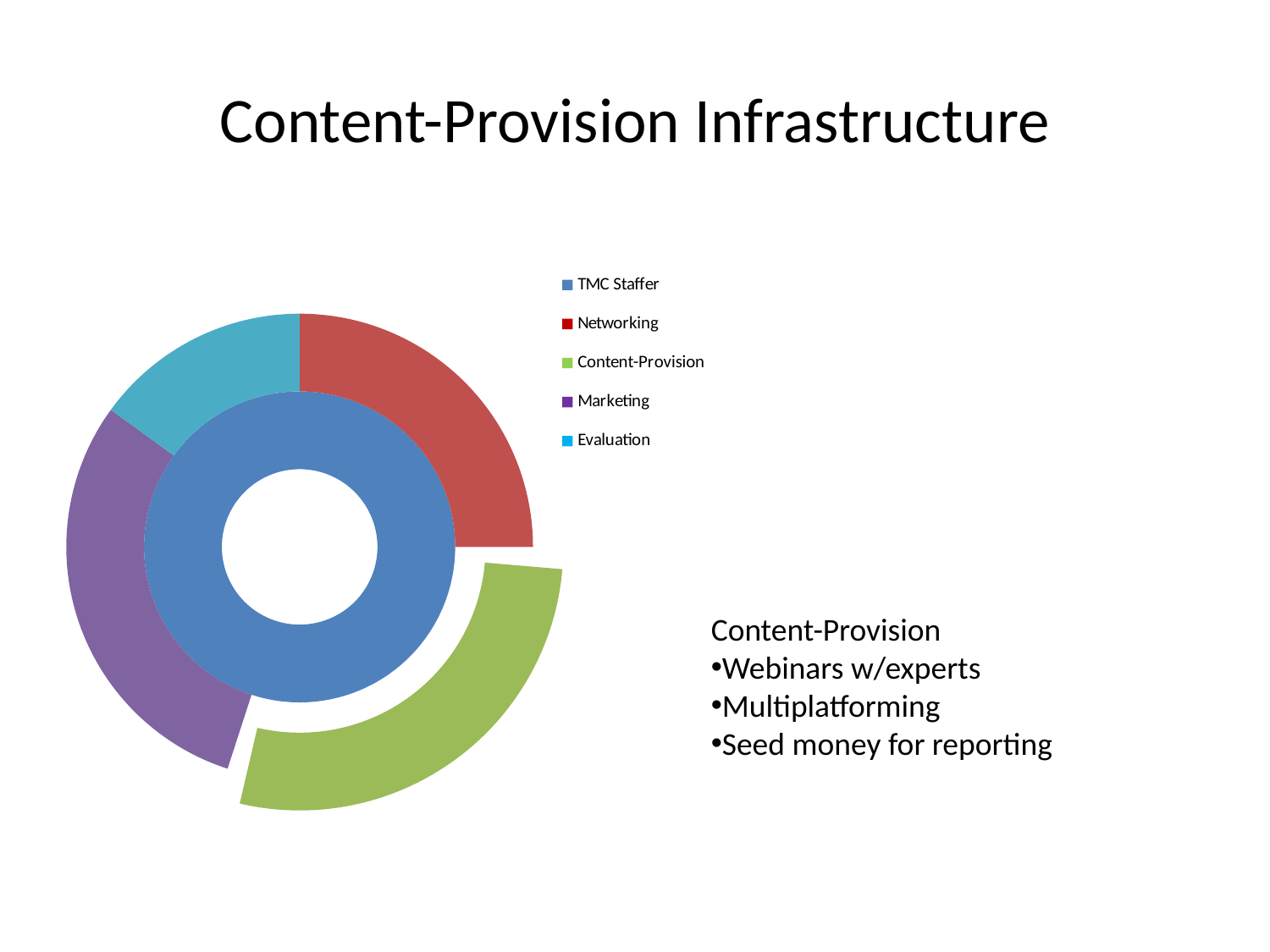
In the outer ring, which segment is larger: Networking or Evaluation? Networking Which segment of the outer ring is pulled out (exploded) from the rest of the chart? Content-Provision In the outer ring, which segment is larger: Marketing or Evaluation? Marketing Which category fills the entire inner ring of the chart? TMC Staffer How many categories does the legend list? 5 Which category has the smallest segment in the outer ring? Evaluation In the outer ring, which segment is larger: Content-Provision or Evaluation? Content-Provision What kind of chart is shown on the slide? Doughnut chart